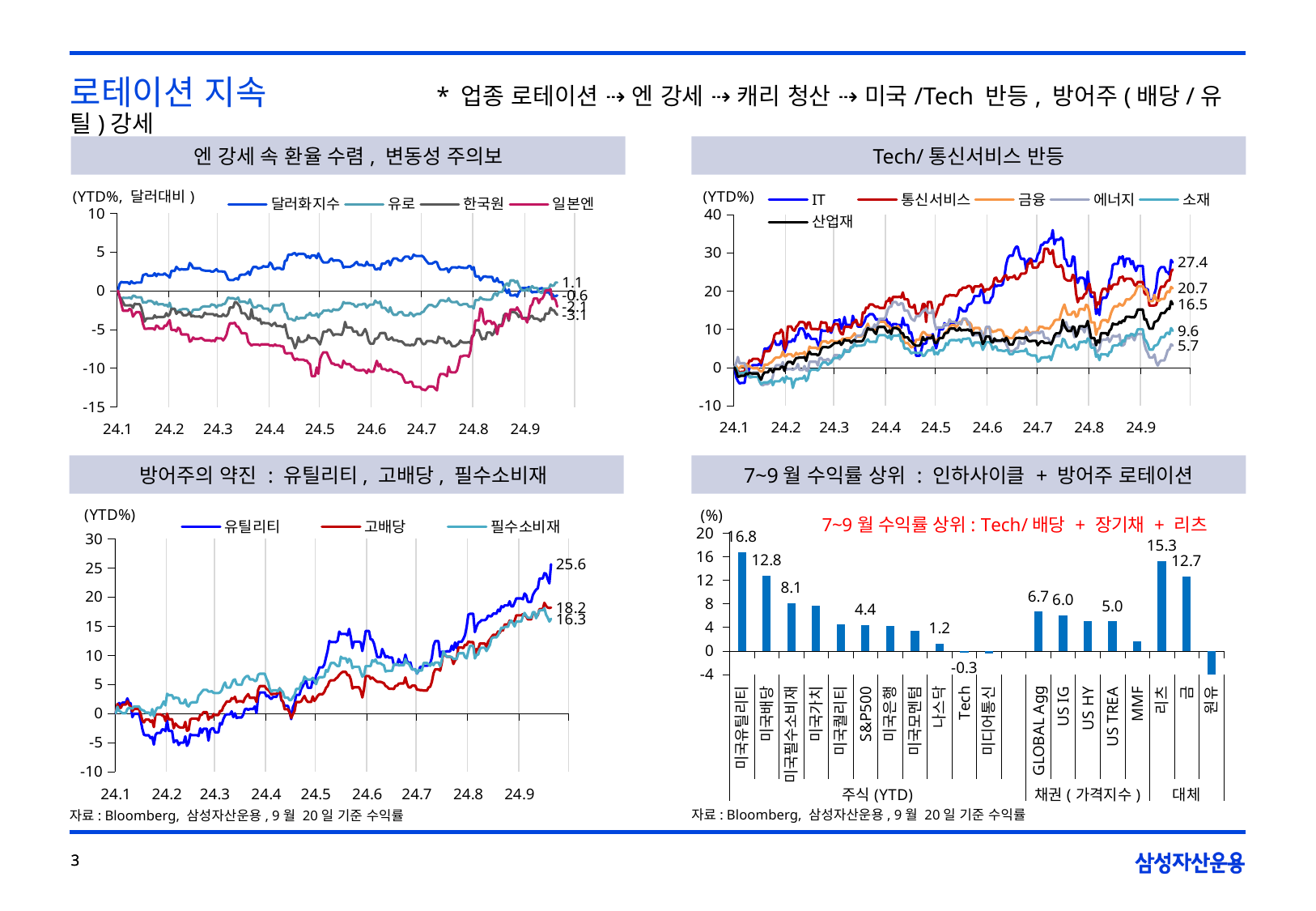
In the bottom-left chart (방어주의 약진), what is the difference between the final values of 고배당 and 필수소비재? 1.9 In the bottom-right bar chart (7~9월 수익률 상위), what is the difference between 미국유틸리티 and 미국배당? 4.0 In the bottom-right bar chart (7~9월 수익률 상위), how many categories are plotted? 19 In the top-right chart (Tech/통신서비스 반등), how many series does the legend list? 6 In the bottom-right bar chart (7~9월 수익률 상위), which category has the lowest value? 원유 In the bottom-left chart (방어주의 약진), what is the final value shown for 유틸리티? 25.6 In the bottom-right bar chart (7~9월 수익률 상위), which is larger, 리츠 or 금? 리츠 In the bottom-right bar chart (7~9월 수익률 상위), is the value for 원유 greater or less than 0? less In the bottom-right bar chart (7~9월 수익률 상위), what is the value for 미국유틸리티? 16.8 In the bottom-right bar chart (7~9월 수익률 상위), which category has the highest value? 미국유틸리티 What kind of chart is the top-left chart (엔 강세 속 환율 수렴, 변동성 주의보)? line chart In the bottom-right bar chart (7~9월 수익률 상위), what is the value for 리츠? 15.3